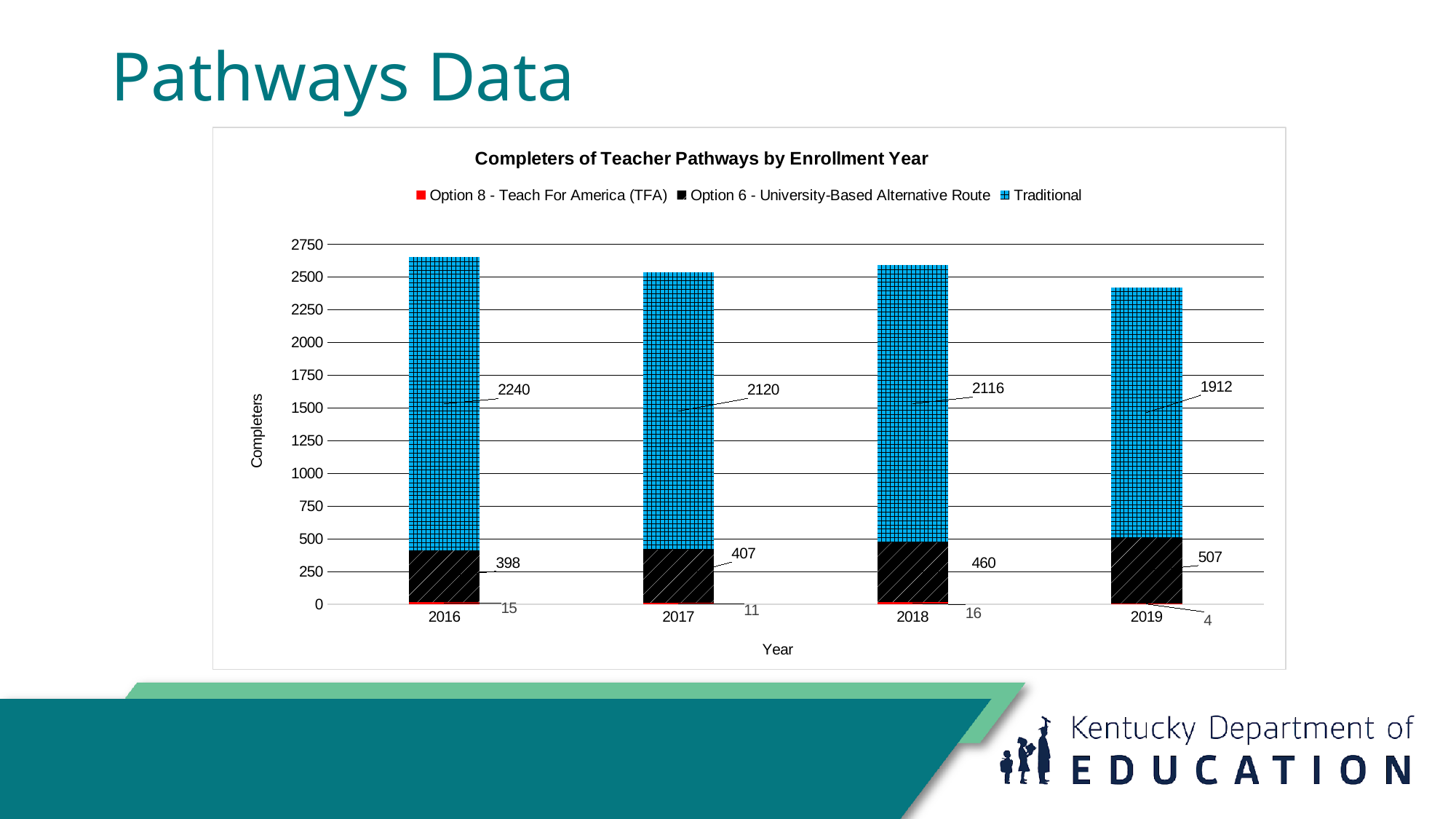
What is the Option 8 - Teach For America (TFA) value for 2017? 11 What is the title of the chart? Completers of Teacher Pathways by Enrollment Year What is the total of the stacked bar for 2019? 2423 How many series does the legend list? 3 What is the Option 6 - University-Based Alternative Route value for 2019? 507 How many years are shown on the x axis? 4 What kind of chart is shown? Stacked bar chart Which is larger, the Option 6 - University-Based Alternative Route value for 2018 or for 2017? 2018 Which year has the highest Traditional value? 2016 What is the difference between the Traditional values for 2016 and 2019? 328 Which year has the lowest Option 8 - Teach For America (TFA) value? 2019 What is the Traditional value for 2016? 2240